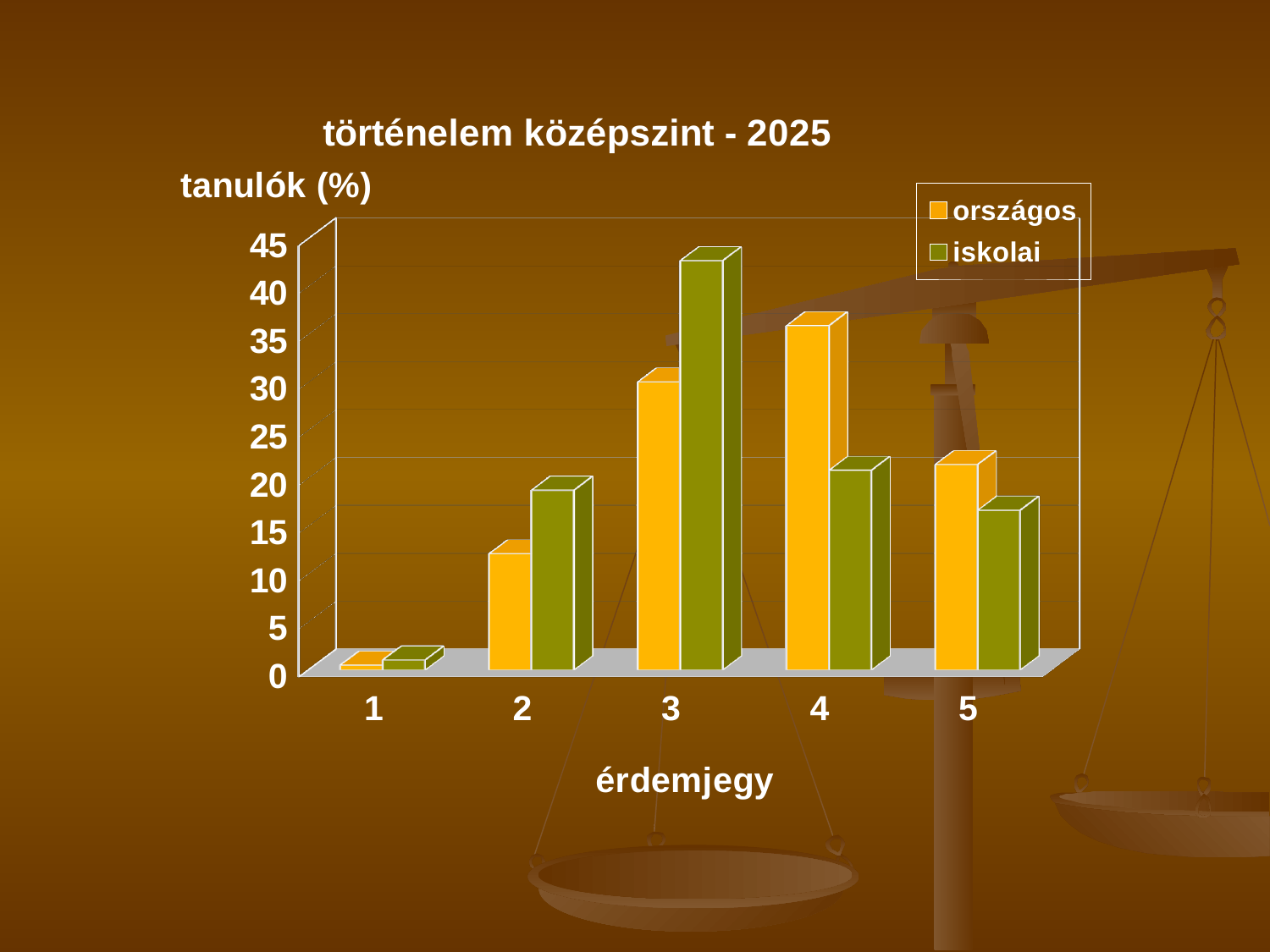
What label is shown on the x axis? érdemjegy For which érdemjegy is the országos value highest? 4 Is the országos value for érdemjegy 2 greater or less than 15? less What is the title of the chart? történelem középszint - 2025 How many series does the legend list? 2 For which érdemjegy is the országos value lowest? 1 For érdemjegy 4, which series has the larger value, országos or iskolai? országos For which érdemjegy is the iskolai value highest? 3 How many categories (érdemjegy values) are shown on the x axis? 5 For érdemjegy 3, which series has the larger value, országos or iskolai? iskolai Is the iskolai value for érdemjegy 3 greater or less than 40? greater What kind of chart is shown on the slide? bar chart